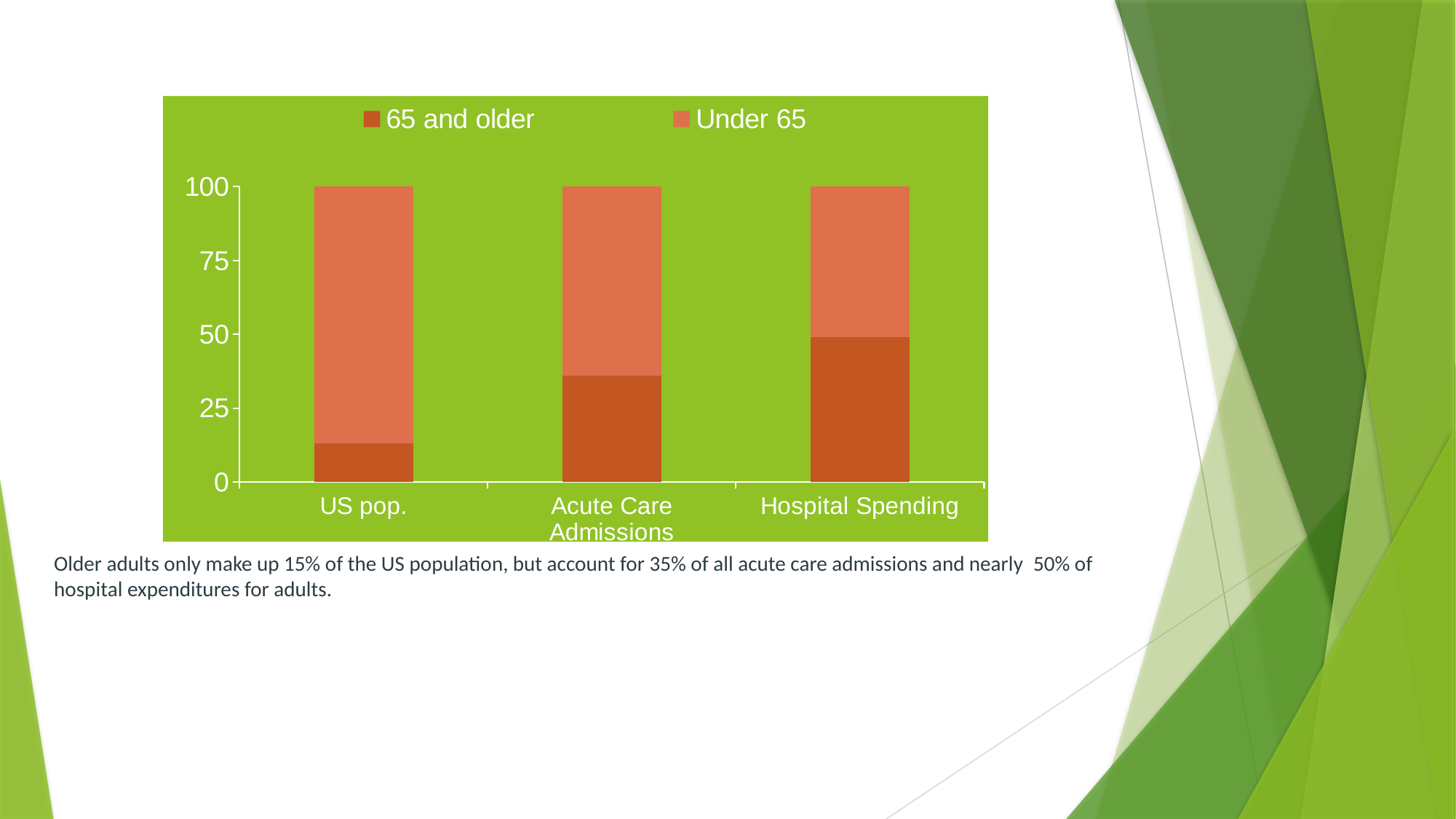
How many series does the chart's legend list? 2 Which category has the largest '65 and older' segment? Hospital Spending Is the 'Under 65' value for US pop. greater or less than 75? greater Which category has the smallest '65 and older' segment? US pop. Do the '65 and older' values rise or fall moving from US pop. to Hospital Spending along the x axis? rise What kind of chart is shown on the slide? Stacked bar chart How many categories are shown on the x axis of the chart? 3 Is the '65 and older' value for Acute Care Admissions greater or less than 25? greater Is the '65 and older' value for US pop. greater or less than 25? less Which category has the largest 'Under 65' segment? US pop. What is the total height of the stacked bar for Hospital Spending? 100 Which is larger, the '65 and older' segment for US pop. or for Acute Care Admissions? Acute Care Admissions